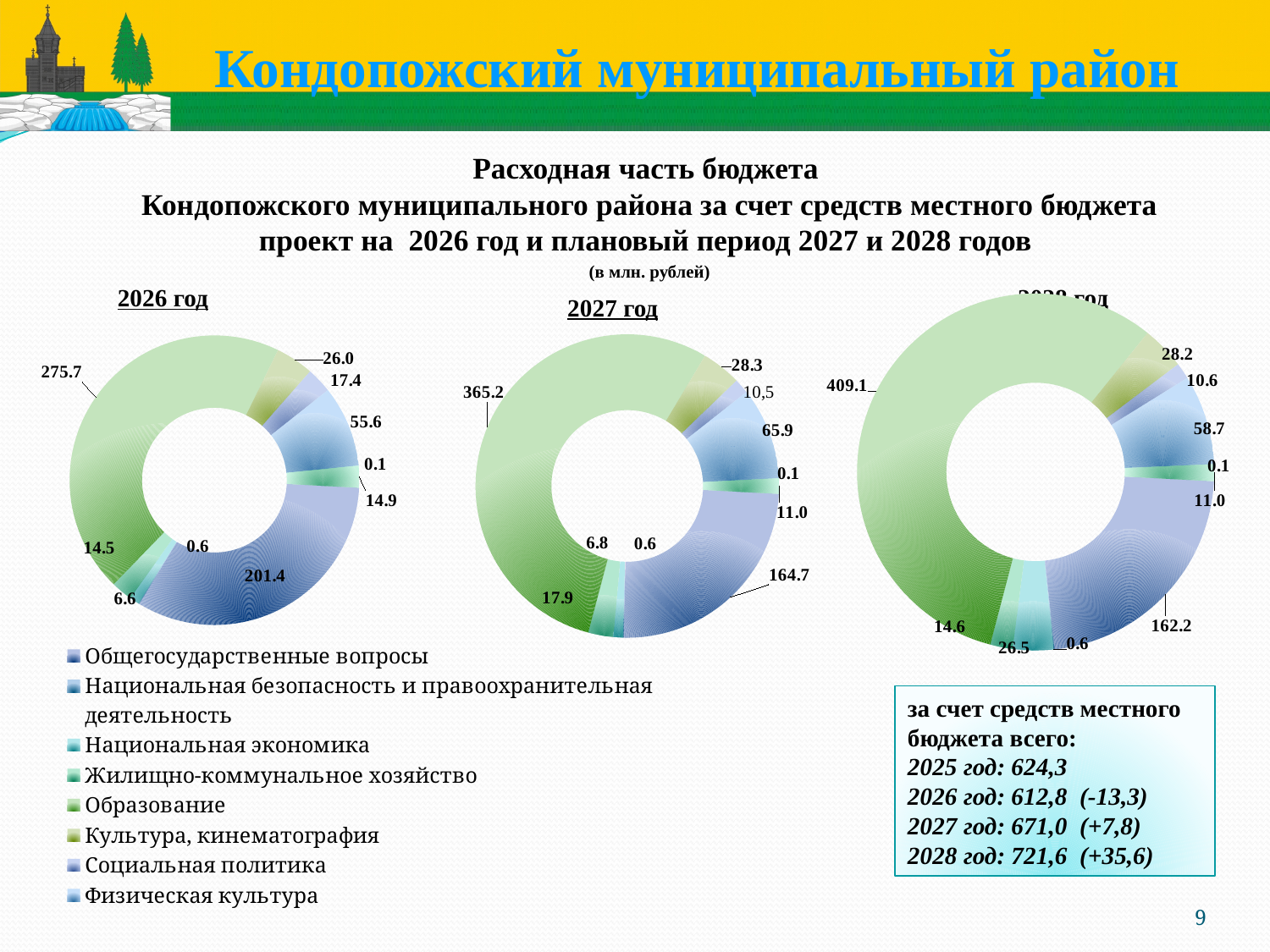
How many charts are shown on the slide? 3 Which is larger: the second-largest slice in the 2026 год chart (201.4) or the second-largest slice in the 2027 год chart (164.7)? 2026 год (201.4) In the 2026 год chart, what is the largest value shown? 275.7 In the 2028 год chart, what is the second-largest value shown? 162.2 In the 2026 год chart, what is the smallest value shown? 0.1 What is the difference between the largest value in the 2028 год chart and the largest value in the 2026 год chart? 133.4 In what units are the chart values given, according to the note under the title? в млн. рублей In the 2028 год chart, what is the largest value shown? 409.1 How many entries does the shared legend list? 8 What is the difference between the largest value in the 2027 год chart and the largest value in the 2026 год chart? 89.5 In the 2027 год chart, what is the largest value shown? 365.2 What kind of chart is used for the 2026 год data? doughnut chart